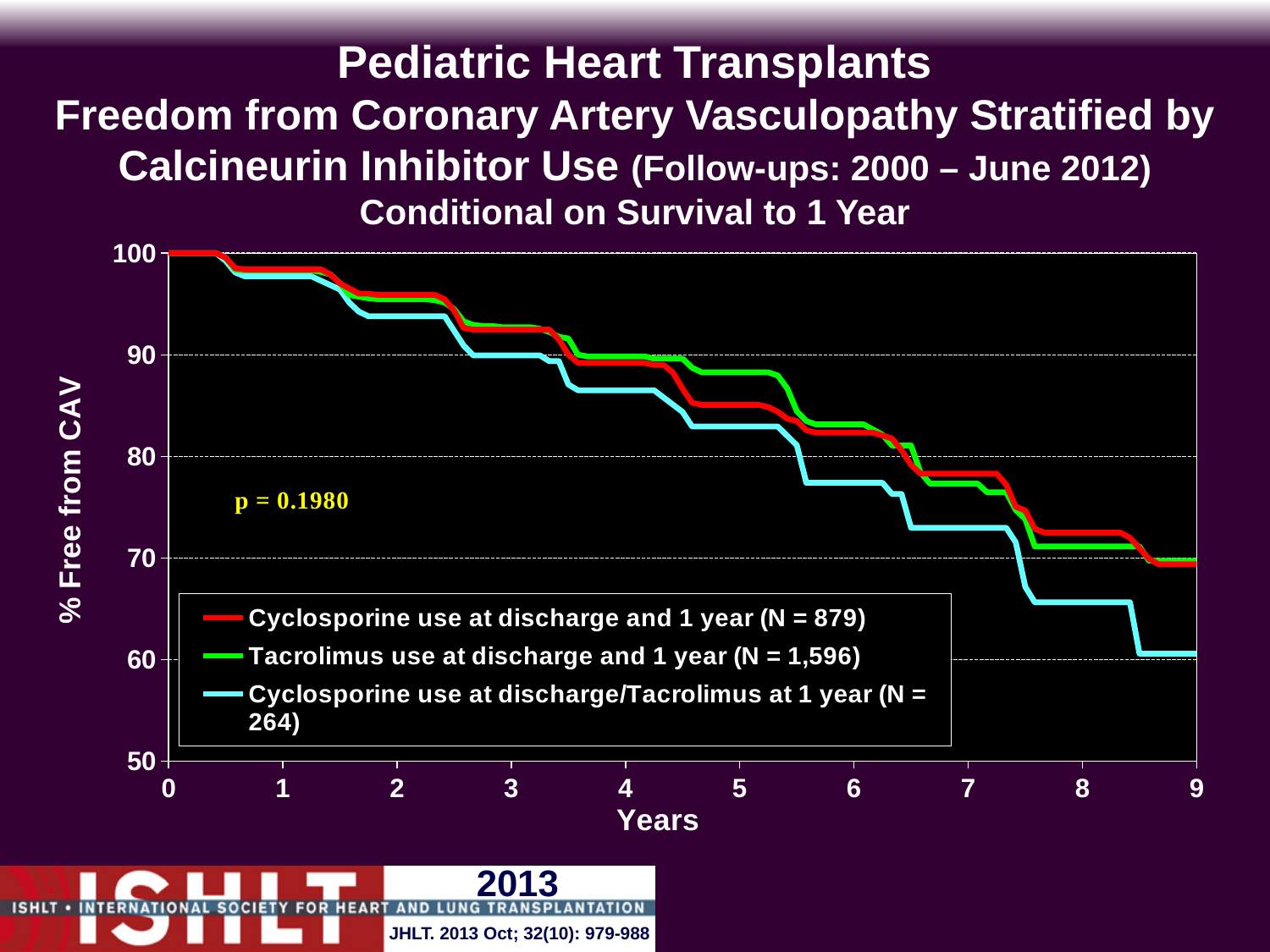
Is the value for Cyclosporine use at discharge/Tacrolimus at 1 year at year 8 greater or less than 70? less How many series does the legend list? 3 What kind of chart is shown on the slide? line chart Do the values for the Cyclosporine use at discharge and 1 year series rise or fall as years increase? fall Is the value for Tacrolimus use at discharge and 1 year at year 5 greater or less than 90? less What p-value is printed on the chart? p = 0.1980 What is the value of all three series at year 0? 100 At year 8, which is larger: the value for Cyclosporine use at discharge and 1 year or the value for Cyclosporine use at discharge/Tacrolimus at 1 year? Cyclosporine use at discharge and 1 year Is the value for Tacrolimus use at discharge and 1 year at year 2 greater or less than 90? greater What is the label of the y axis? % Free from CAV Which series has the lowest value at year 8? Cyclosporine use at discharge/Tacrolimus at 1 year